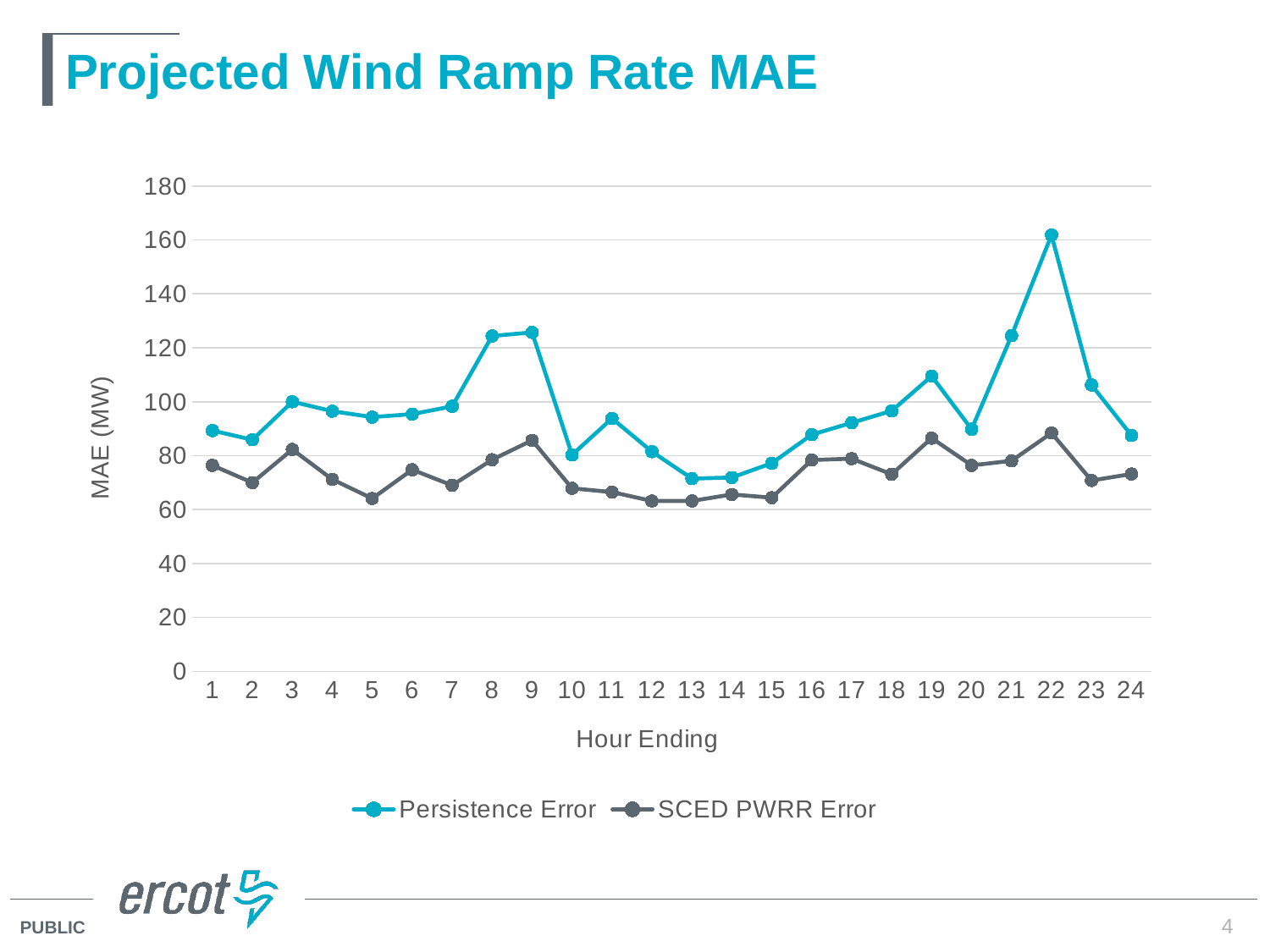
Is the Persistence Error at hour ending 10 greater or less than 100? less Is the Persistence Error at hour ending 8 greater or less than 120? greater How many series does the legend list? 2 At hour ending 22, which series has the larger value, Persistence Error or SCED PWRR Error? Persistence Error How many hours are plotted along the x axis? 24 Is the Persistence Error at hour ending 22 greater or less than 140? greater At which hour ending does the Persistence Error reach its highest value? 22 What kind of chart is shown on the slide? Line chart Which series is higher across all hours, Persistence Error or SCED PWRR Error? Persistence Error What is the label on the y axis? MAE (MW) Does the Persistence Error rise or fall from hour ending 22 to hour ending 24? Fall